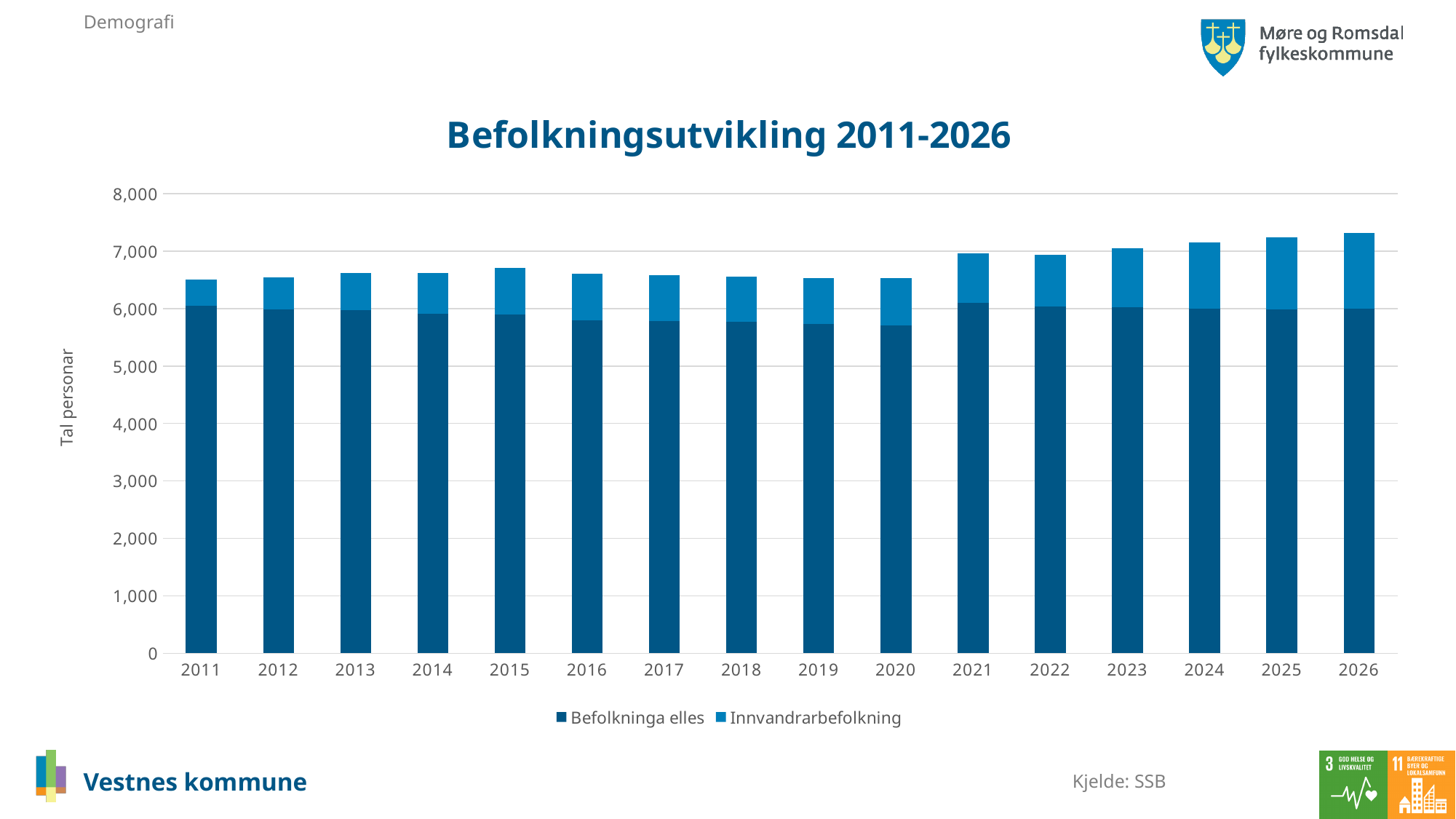
Is the value for Befolkninga elles in 2020 greater or less than 6,000? less What kind of chart is shown on the slide? Bar chart Which year has the larger total bar, 2011 or 2026? 2026 Which year has the highest total bar? 2026 Is the total value for 2011 greater or less than 7,000? less What is the title of the chart? Befolkningsutvikling 2011-2026 Is the total value for 2026 greater or less than 7,000? greater What label is shown on the y axis of the chart? Tal personar How many years are shown on the x axis of the chart? 16 How many series does the legend list? 2 Which year has the larger total bar, 2020 or 2021? 2021